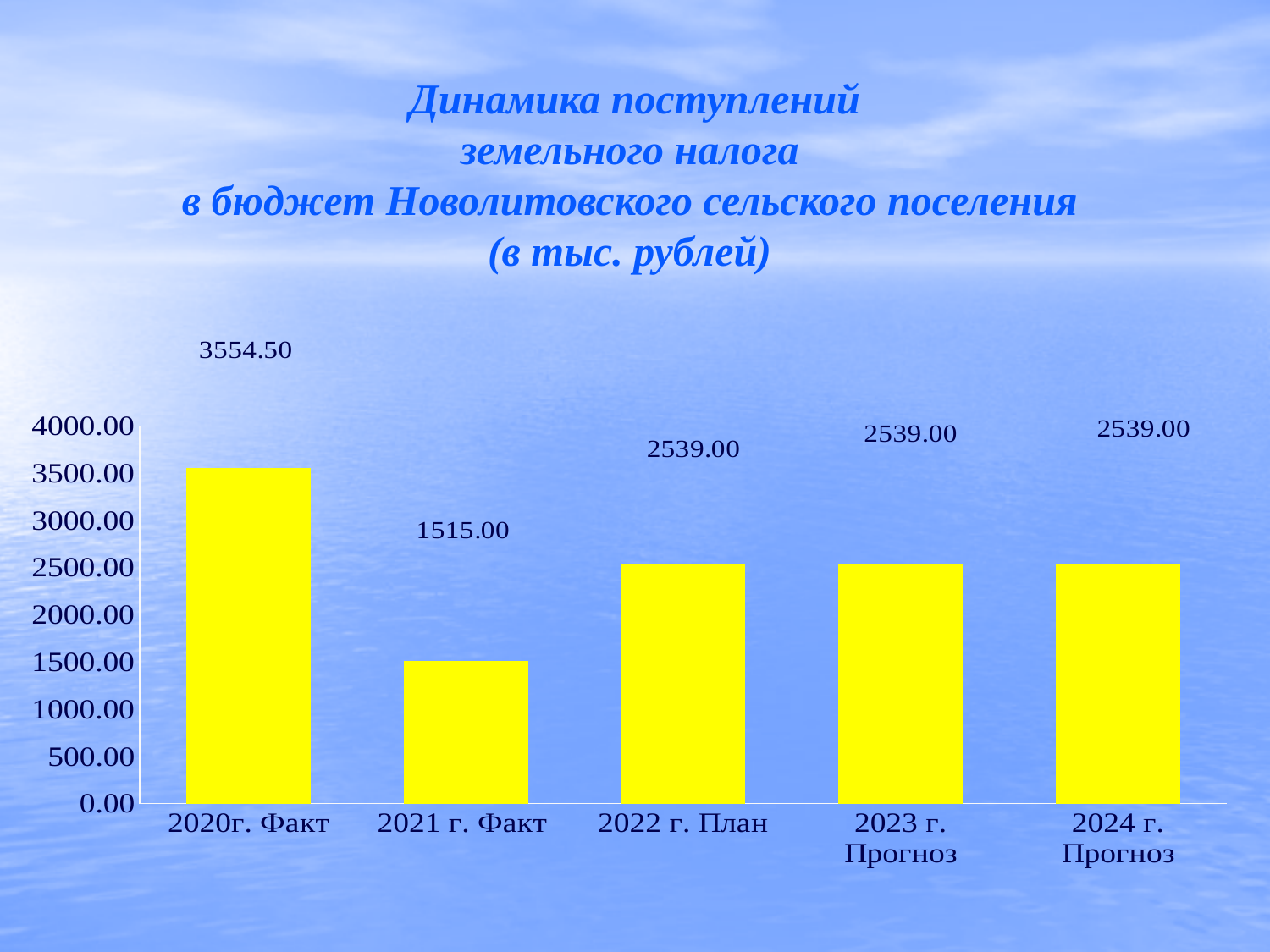
Which is larger, the value for 2021 г. Факт or the value for 2023 г. Прогноз? 2023 г. Прогноз How many categories are shown on the x axis? 5 What is the difference between the values for 2020г. Факт and 2021 г. Факт? 2039.50 Which category has the lowest value? 2021 г. Факт What is the value for 2021 г. Факт? 1515.00 What kind of chart is shown on the slide? bar chart What is the value for 2022 г. План? 2539.00 Which category has the highest value? 2020г. Факт What is the value for 2024 г. Прогноз? 2539.00 What is the difference between the values for 2022 г. План and 2021 г. Факт? 1024.00 What is the value for 2020г. Факт? 3554.50 What colour are the bars in the chart? yellow